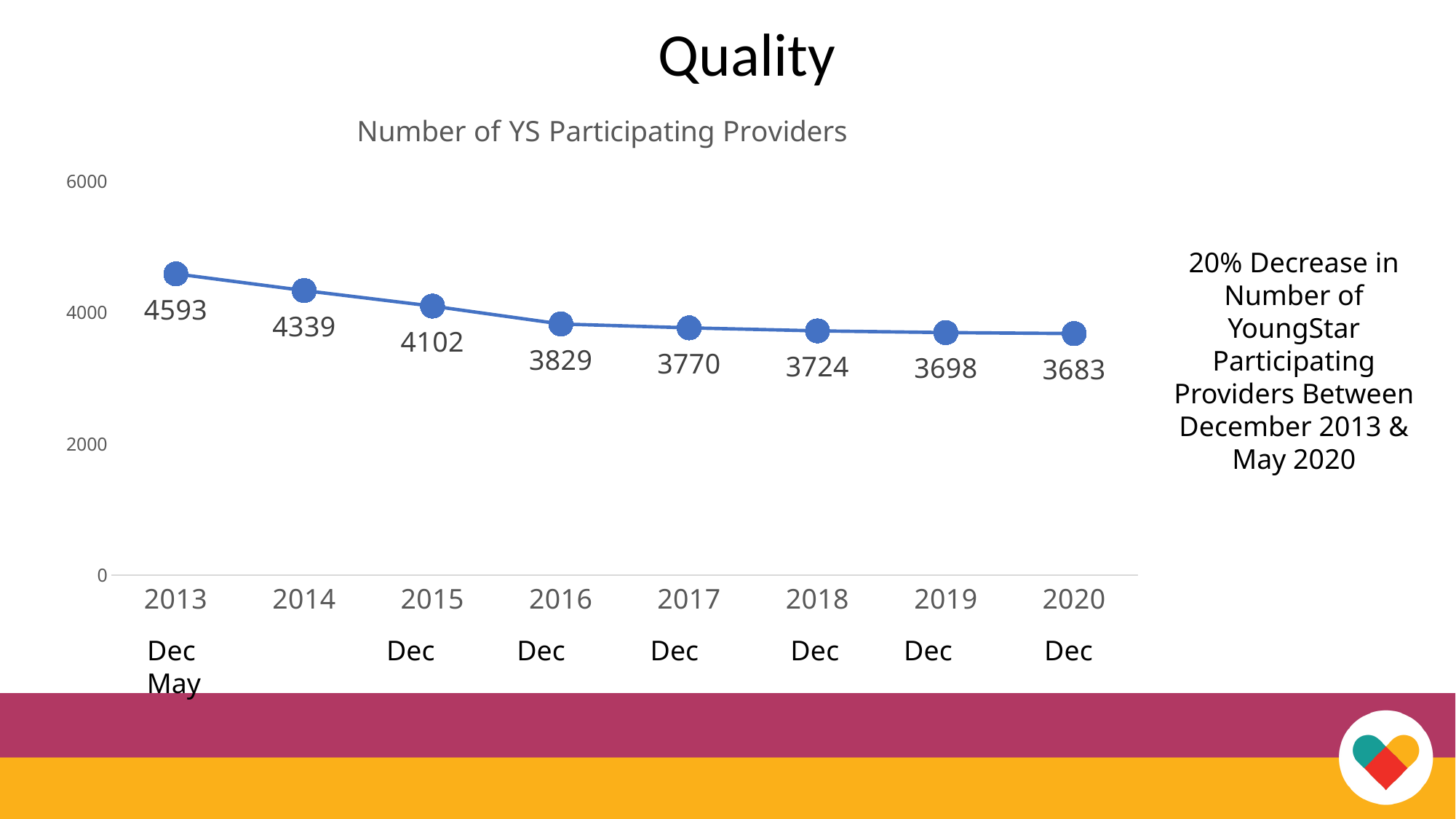
What is the number of YS participating providers in 2016? 3829 What is the difference in the number of YS participating providers between 2013 and 2020? 910 Which year has the lowest number of YS participating providers? 2020 What kind of chart is shown on the slide? line chart Is the value for 2018 greater or less than 4000? less How many years are plotted on the chart? 8 Do the values rise or fall from 2013 to 2020? fall Which year has the highest number of YS participating providers? 2013 What is the number of YS participating providers in 2013? 4593 What is the difference in the number of YS participating providers between 2014 and 2015? 237 What is the number of YS participating providers in 2020? 3683 Which year has more YS participating providers, 2015 or 2017? 2015